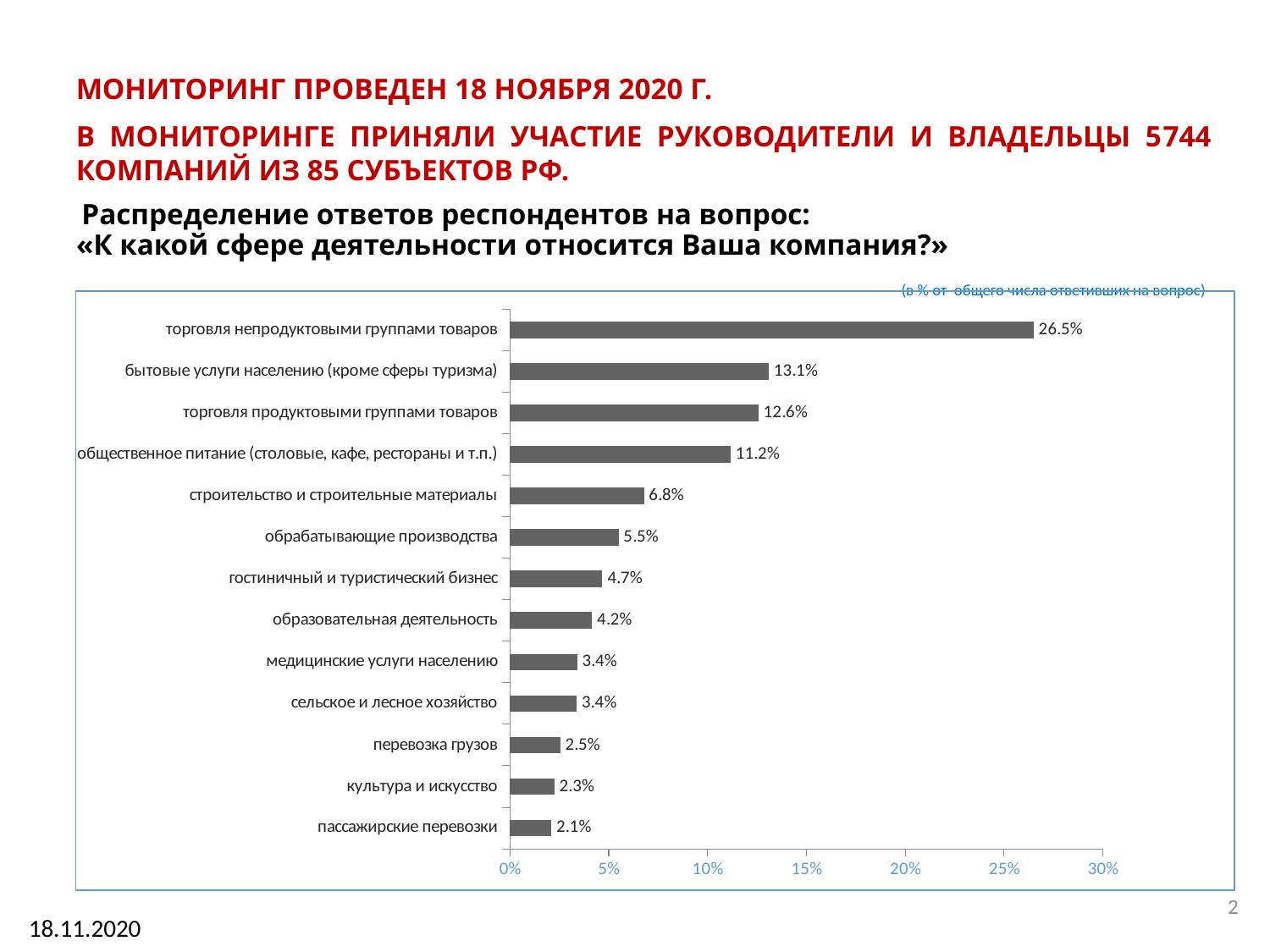
What is the difference between «бытовые услуги населению (кроме сферы туризма)» and «торговля продуктовыми группами товаров»? 0.5% What is the difference between «торговля непродуктовыми группами товаров» and «пассажирские перевозки»? 24.4% Which category has the lowest value? пассажирские перевозки What is the maximum value shown on the horizontal axis? 30% How many categories are shown in the chart? 13 What is the value for «общественное питание (столовые, кафе, рестораны и т.п.)»? 11.2% Is the value for «образовательная деятельность» greater or less than 5%? less What is the value for «торговля непродуктовыми группами товаров»? 26.5% Which is larger: «строительство и строительные материалы» or «обрабатывающие производства»? строительство и строительные материалы What kind of chart is shown on the slide? bar chart Which category has the highest value? торговля непродуктовыми группами товаров What is the value for «гостиничный и туристический бизнес»? 4.7%